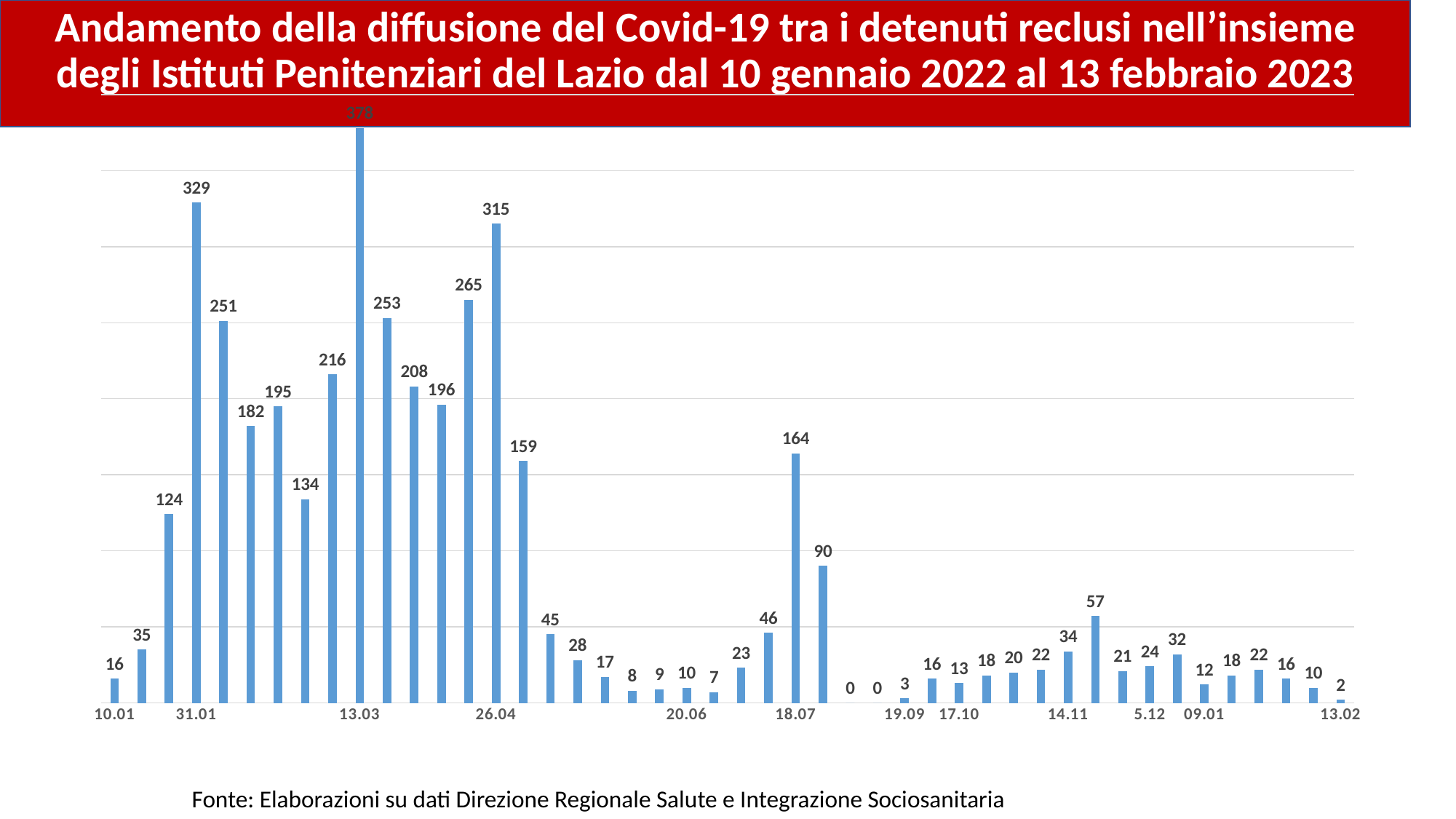
What kind of chart is shown on the slide? Bar chart What is the difference between the values for 31.01 and 26.04? 14 Which labelled date has the highest value? 13.03 Which is larger, the value for 18.07 or the value for 14.11? 18.07 What is the value for 26.04? 315 What is the value for 13.03? 378 What is the value for 18.07? 164 What is the value for 31.01? 329 What is the lowest value shown on the chart? 0 What is the value for 10.01? 16 What is the value for 14.11? 34 What is the value for 13.02? 2